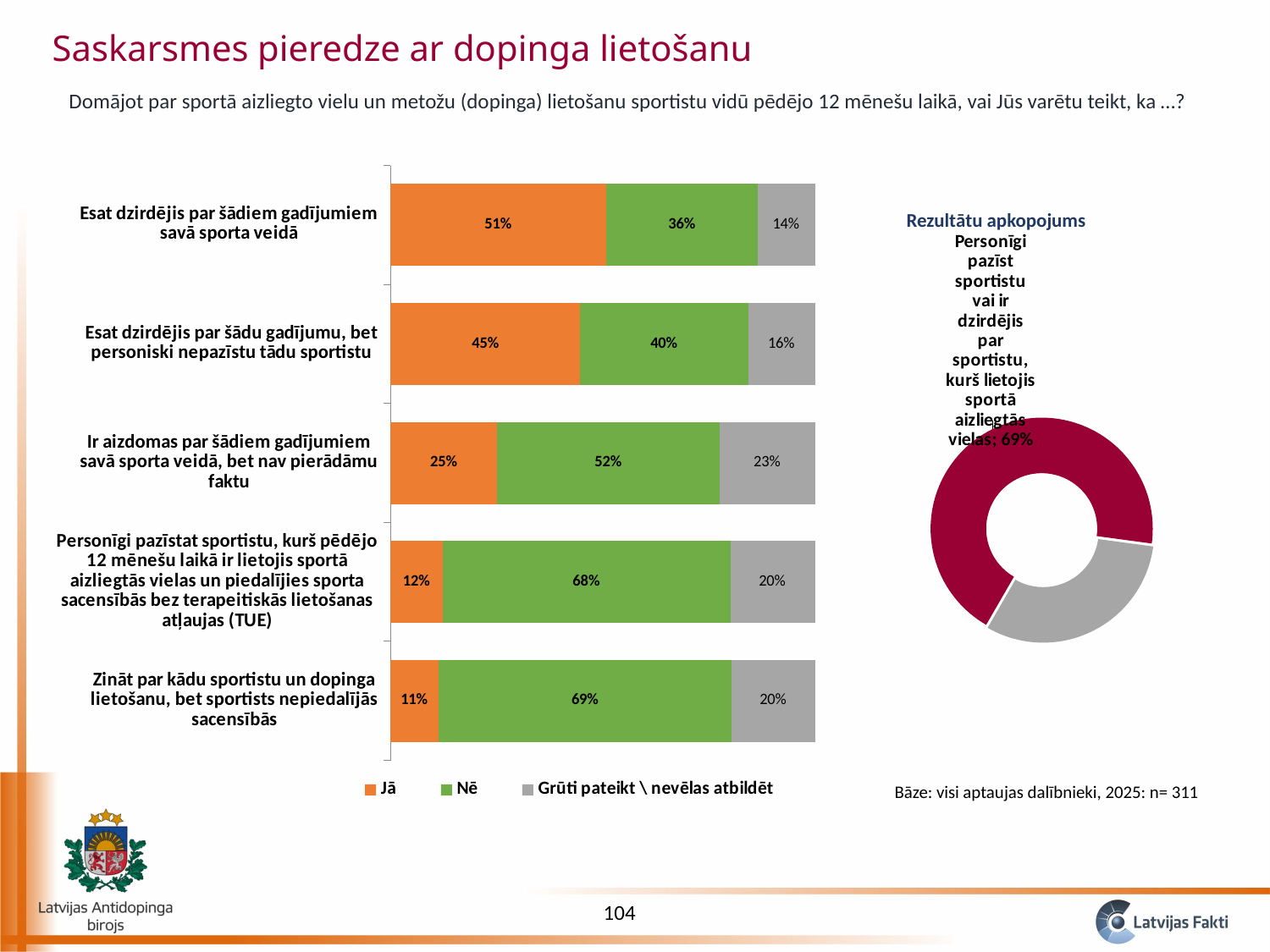
How many categories does the stacked bar chart on the left show? 5 How many series does the legend of the stacked bar chart on the left list? 3 In the stacked bar chart on the left, what is the "Grūti pateikt \ nevēlas atbildēt" value for "Esat dzirdējis par šādu gadījumu, bet personiski nepazīstu tādu sportistu"? 16% What type of chart is the "Rezultātu apkopojums" chart on the right of the slide? Doughnut chart What type of chart is the chart on the left of the slide? Stacked bar chart In the stacked bar chart on the left, what is the difference between the "Nē" value for "Zināt par kādu sportistu un dopinga lietošanu, bet sportists nepiedalījās sacensībās" and the "Nē" value for "Esat dzirdējis par šādiem gadījumiem savā sporta veidā"? 33% In the stacked bar chart on the left, what is the "Jā" value for "Esat dzirdējis par šādiem gadījumiem savā sporta veidā"? 51% In the stacked bar chart on the left, which category has the lowest "Jā" value? Zināt par kādu sportistu un dopinga lietošanu, bet sportists nepiedalījās sacensībās In the stacked bar chart on the left, what is the "Nē" value for "Ir aizdomas par šādiem gadījumiem savā sporta veidā, bet nav pierādāmu faktu"? 52% In the stacked bar chart on the left, which is larger: the "Jā" value or the "Nē" value for "Esat dzirdējis par šādu gadījumu, bet personiski nepazīstu tādu sportistu"? Jā In the stacked bar chart on the left, which category has the highest "Jā" value? Esat dzirdējis par šādiem gadījumiem savā sporta veidā In the "Rezultātu apkopojums" chart on the right, what share is shown for "Personīgi pazīst sportistu vai ir dzirdējis par sportistu, kurš lietojis sportā aizliegtās vielas"? 69%